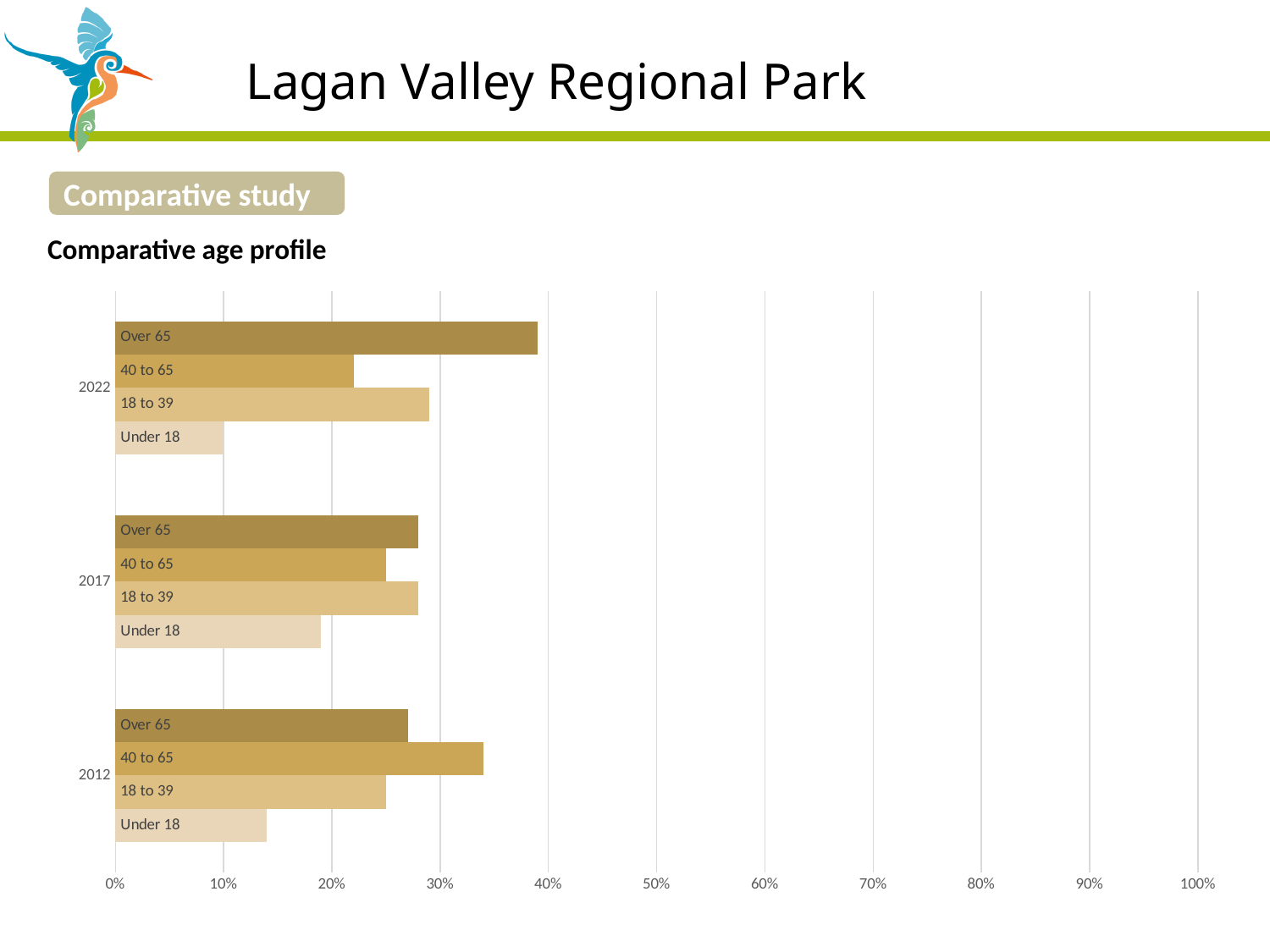
In 2022, which age group has the largest share? Over 65 Which year has the larger share for Over 65, 2022 or 2017? 2022 In 2022, which age group has the smallest share? Under 18 What is the title of the chart? Comparative age profile Is the value for Over 65 in 2022 greater or less than 30%? greater In 2017, which age group has the smallest share? Under 18 How many years are compared in the chart? 3 How many age groups are shown for each year? 4 Is the value for 40 to 65 in 2012 greater or less than 30%? greater In 2012, which age group has the largest share? 40 to 65 What kind of chart is shown on the slide? bar chart